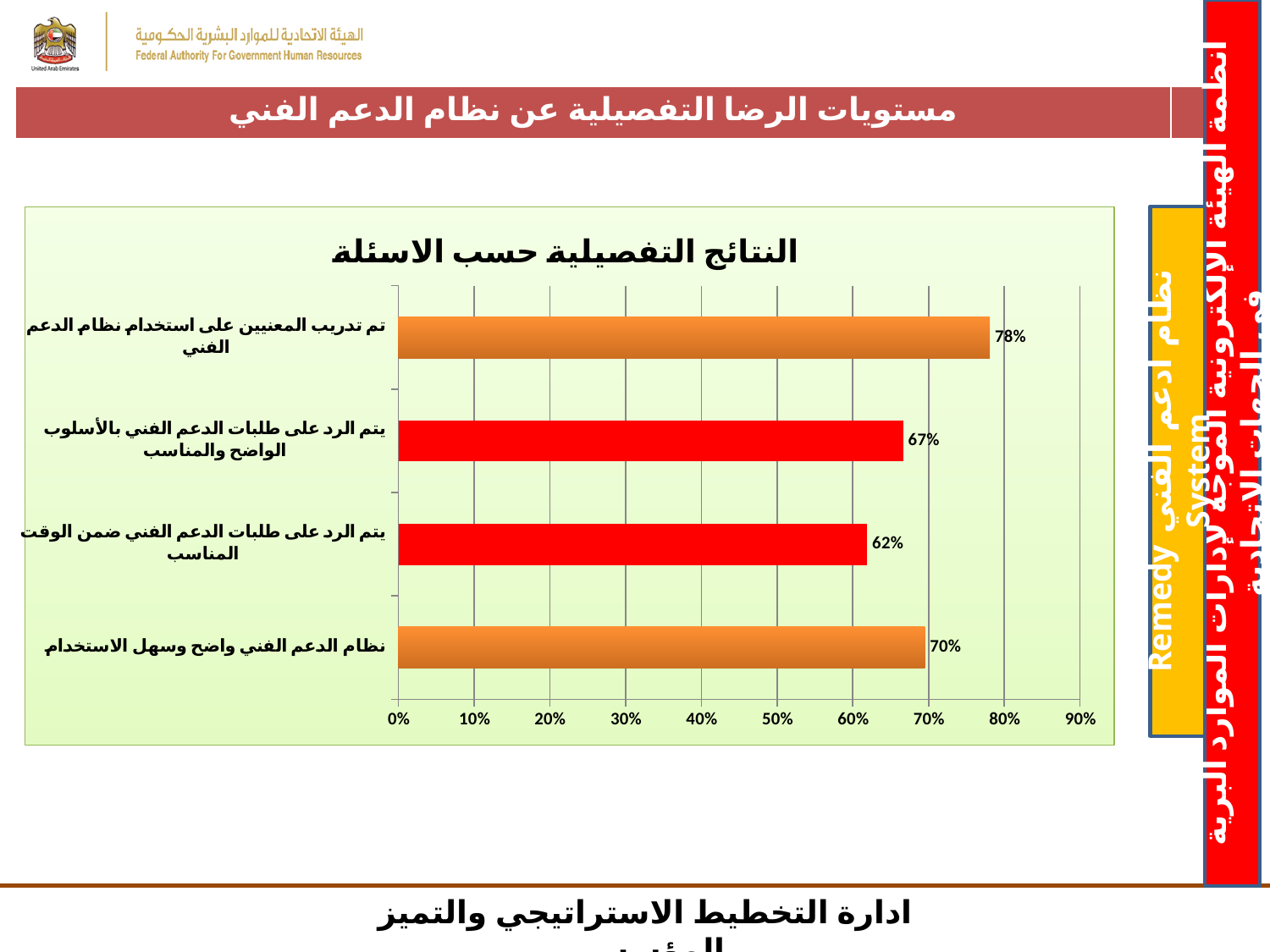
What is the value for "يتم الرد على طلبات الدعم الفني بالأسلوب الواضح والمناسب"? 67% Which is larger: the value for "نظام الدعم الفني واضح وسهل الاستخدام" or the value for "يتم الرد على طلبات الدعم الفني بالأسلوب الواضح والمناسب"? نظام الدعم الفني واضح وسهل الاستخدام How many categories are shown in the chart? 4 What is the difference between the highest value (78%) and the lowest value (62%)? 16% Which category has the highest value? تم تدريب المعنيين على استخدام نظام الدعم الفني What is the value for "تم تدريب المعنيين على استخدام نظام الدعم الفني"? 78% What is the title of the chart? النتائج التفصيلية حسب الاسئلة Is the value for "يتم الرد على طلبات الدعم الفني ضمن الوقت المناسب" greater or less than 70%? less What kind of chart is shown on the slide? bar chart What is the value for "يتم الرد على طلبات الدعم الفني ضمن الوقت المناسب"? 62% Which category has the lowest value? يتم الرد على طلبات الدعم الفني ضمن الوقت المناسب What is the value for "نظام الدعم الفني واضح وسهل الاستخدام"? 70%